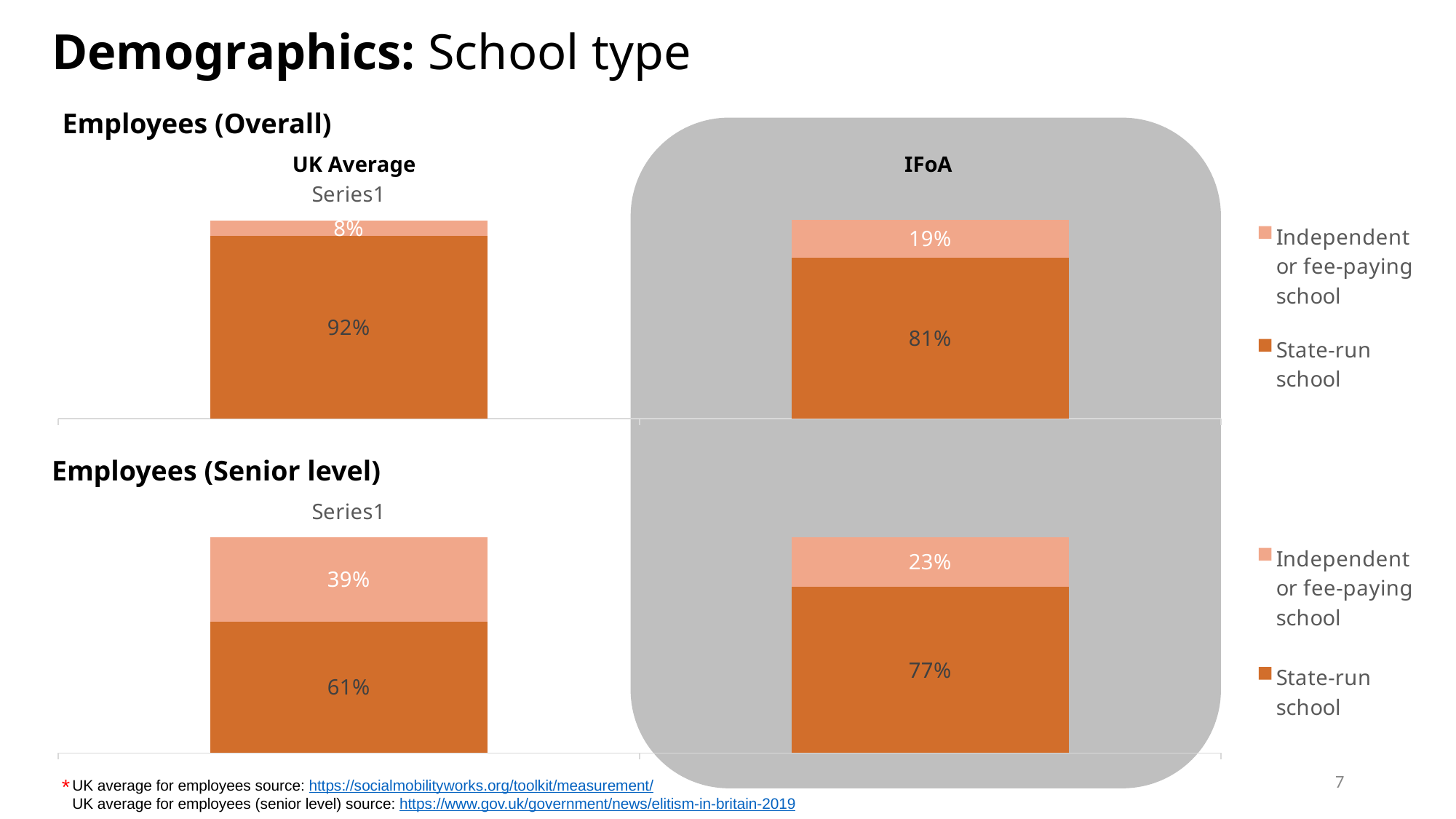
In the Employees (Senior level) chart, what is the difference between the Independent or fee-paying school share for UK Average and for IFoA? 16 percentage points In the Employees (Overall) chart, what is the total of the IFoA stacked bar? 100% In the Employees (Overall) chart, what percentage of the UK Average bar is State-run school? 92% What type of chart is used in the Employees (Senior level) section? Stacked bar chart In the Employees (Senior level) chart, what percentage of the UK Average bar is Independent or fee-paying school? 39% In the Employees (Senior level) chart, which has the larger State-run school share, UK Average or IFoA? IFoA In the Employees (Overall) chart, what is the difference between the State-run school share for UK Average and for IFoA? 11 percentage points How many series does the legend list for the Employees (Overall) chart? 2 In the Employees (Senior level) chart, which colour represents State-run school? Dark orange In the Employees (Senior level) chart, what percentage of the IFoA bar is State-run school? 77% In the Employees (Overall) chart, which has the larger Independent or fee-paying school share, UK Average or IFoA? IFoA In the Employees (Overall) chart, what percentage of the IFoA bar is Independent or fee-paying school? 19%